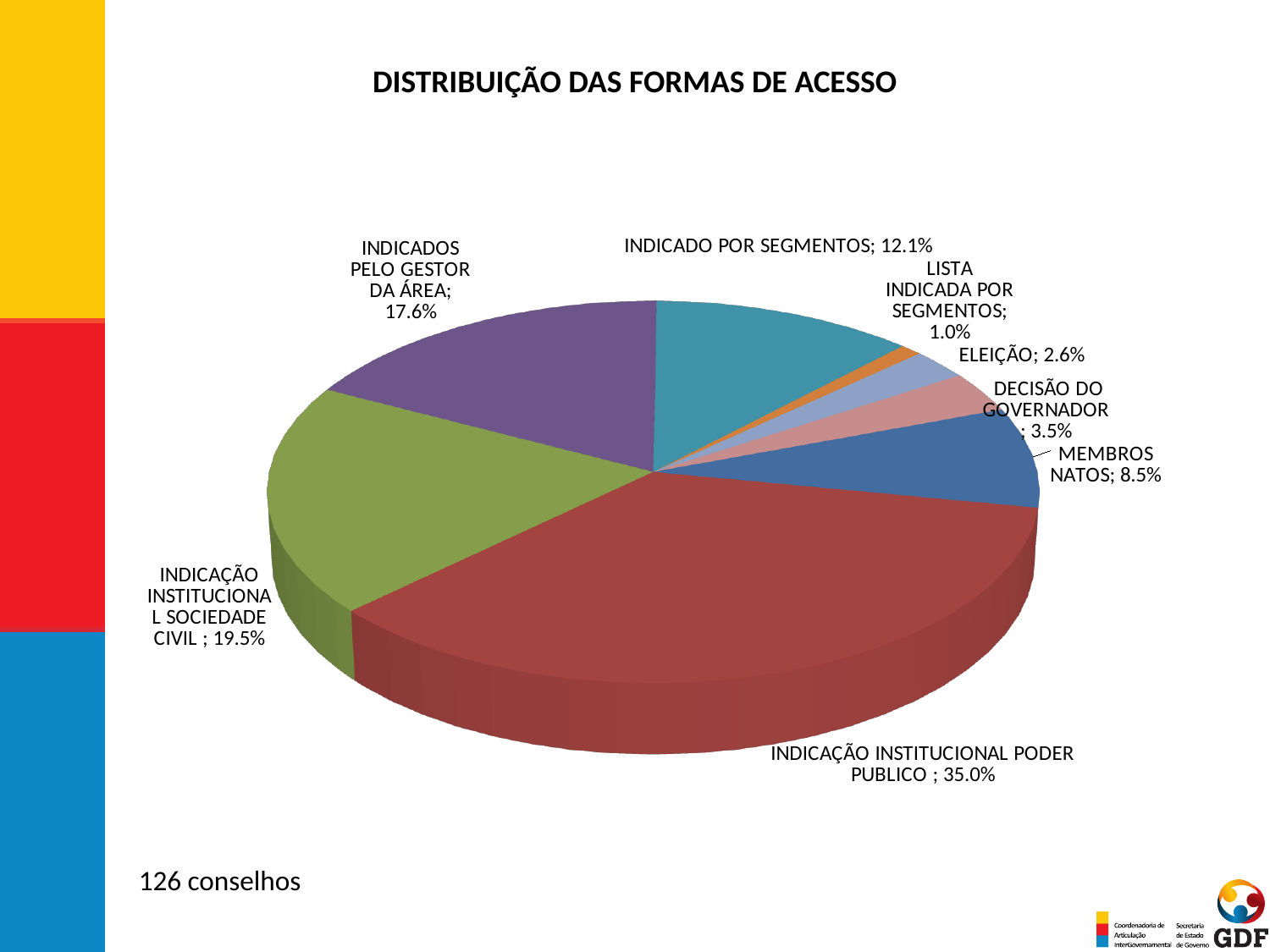
Which category has the smallest slice of the pie? LISTA INDICADA POR SEGMENTOS What is the title of the chart? DISTRIBUIÇÃO DAS FORMAS DE ACESSO What is the difference in percentage points between INDICAÇÃO INSTITUCIONAL SOCIEDADE CIVIL and INDICADOS PELO GESTOR DA ÁREA? 1.9 What percentage is shown for ELEIÇÃO? 2.6% What percentage is shown for INDICADOS PELO GESTOR DA ÁREA? 17.6% What percentage is shown for MEMBROS NATOS? 8.5% Which category has the largest slice of the pie? INDICAÇÃO INSTITUCIONAL PODER PUBLICO What share of the pie is INDICAÇÃO INSTITUCIONAL PODER PUBLICO? 35.0% How many slices does the pie chart have? 8 What kind of chart is shown on the slide? Pie chart Which is larger, INDICADO POR SEGMENTOS or MEMBROS NATOS? INDICADO POR SEGMENTOS What is the difference in percentage points between DECISÃO DO GOVERNADOR and ELEIÇÃO? 0.9